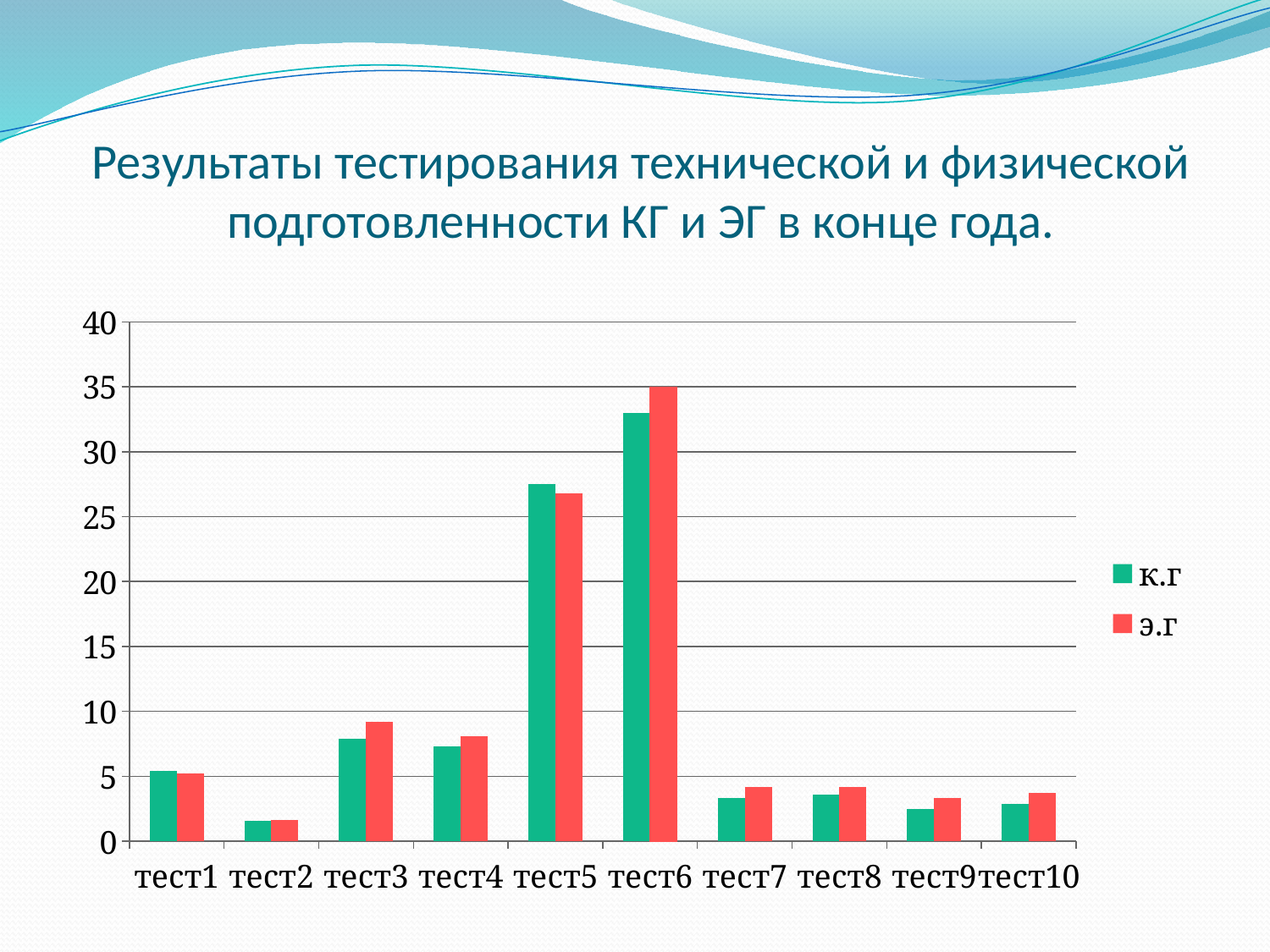
How many test categories are shown along the x axis? 10 Which test has the highest value for the К.Г series? тест6 What kind of chart is shown on the slide? bar chart How many series does the legend list? 2 In тест6, which series has the larger value, К.Г or Э.Г? Э.Г Which test has the highest value for the Э.Г series? тест6 What colour are the bars for the Э.Г series? red Is the value for К.Г in тест6 greater or less than 30? greater In тест3, which series has the larger value, К.Г or Э.Г? Э.Г Is the value for К.Г in тест3 greater or less than 10? less Which test has the lowest value for the К.Г series? тест2 Is the value for Э.Г in тест5 greater or less than 25? greater